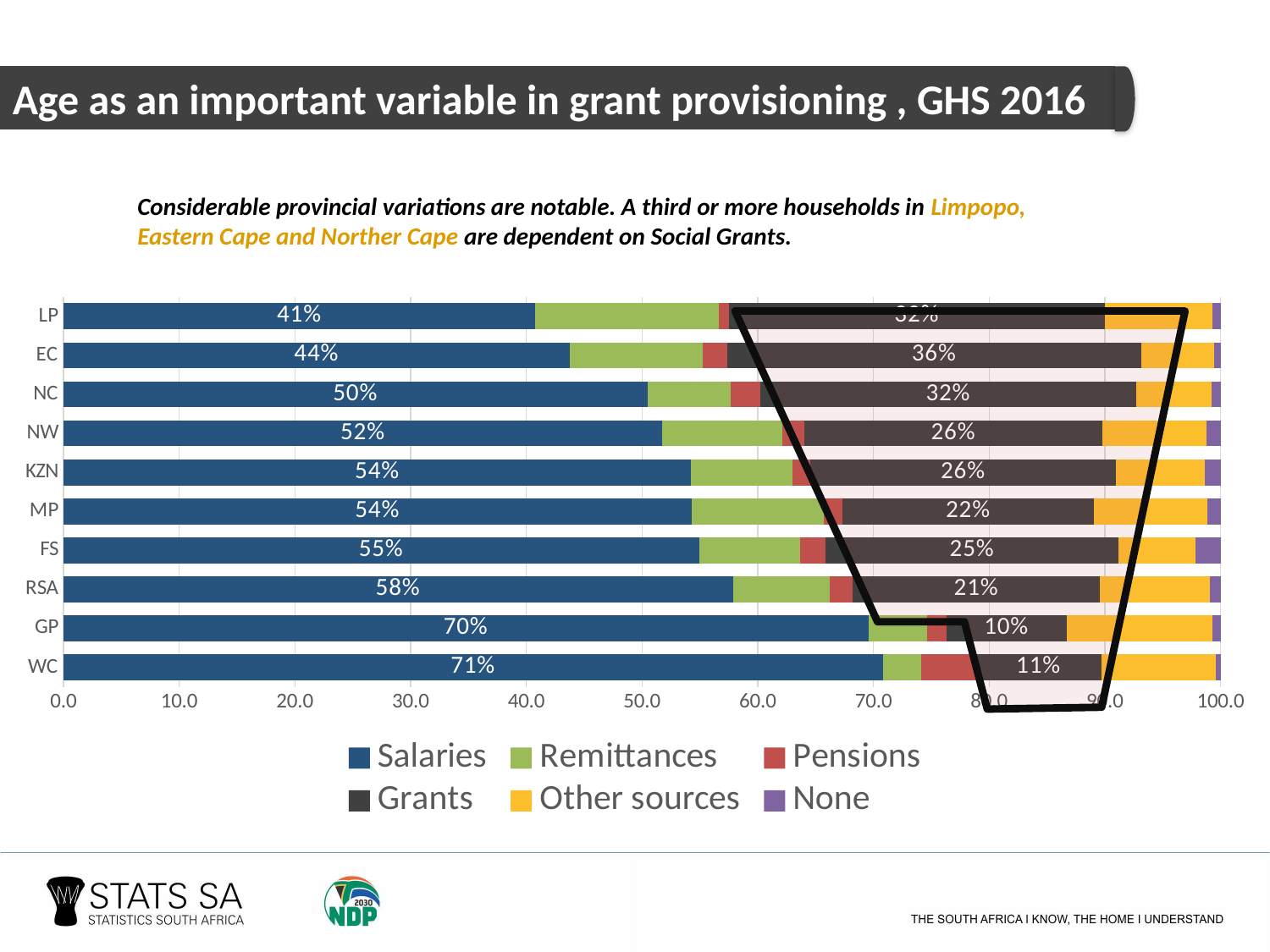
Which province has the lowest Salaries value? LP Which category has the lowest Grants value? GP How many categories are shown on the y axis of the chart? 10 What is the Salaries value for WC? 71% Which series is shown in yellow in the legend? Other sources What is the Salaries value for NC? 50% What kind of chart is shown on the slide? Stacked bar chart Which has a larger Grants value, EC or NC? EC What is the Grants value for GP? 10% What is the difference between the Salaries values for WC and LP? 30 percentage points How many series does the legend list? 6 What is the Grants value for EC? 36%